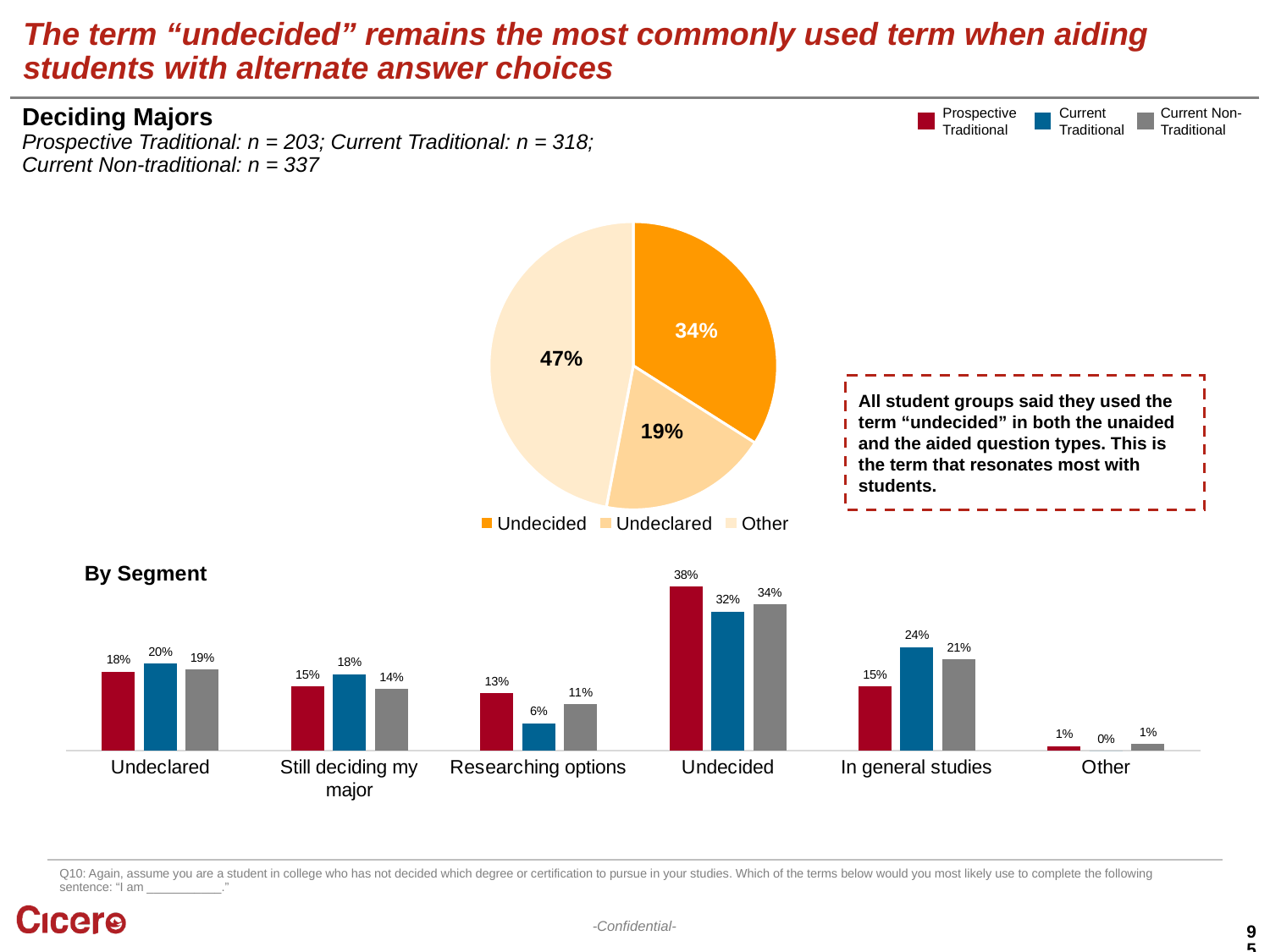
In the By Segment bar chart, how many categories are shown on the x axis? 6 In the pie chart, which slice is the smallest? Undeclared In the pie chart, what share is labelled for the Undecided slice? 34% In the pie chart, how many slices are there? 3 In the By Segment bar chart, what is the difference between Current Traditional and Prospective Traditional in the In general studies category? 9% What kind of chart is the By Segment chart? Bar chart In the pie chart, which slice is the largest? Other In the By Segment bar chart, which category has the highest value for Current Traditional? Undecided In the By Segment bar chart, how many series does the legend list? 3 In the By Segment bar chart, which is larger for Current Non-Traditional: Undeclared or Still deciding my major? Undeclared In the By Segment bar chart, what is the value for Current Traditional in the Researching options category? 6% In the By Segment bar chart, what is the value for Prospective Traditional in the Undecided category? 38%